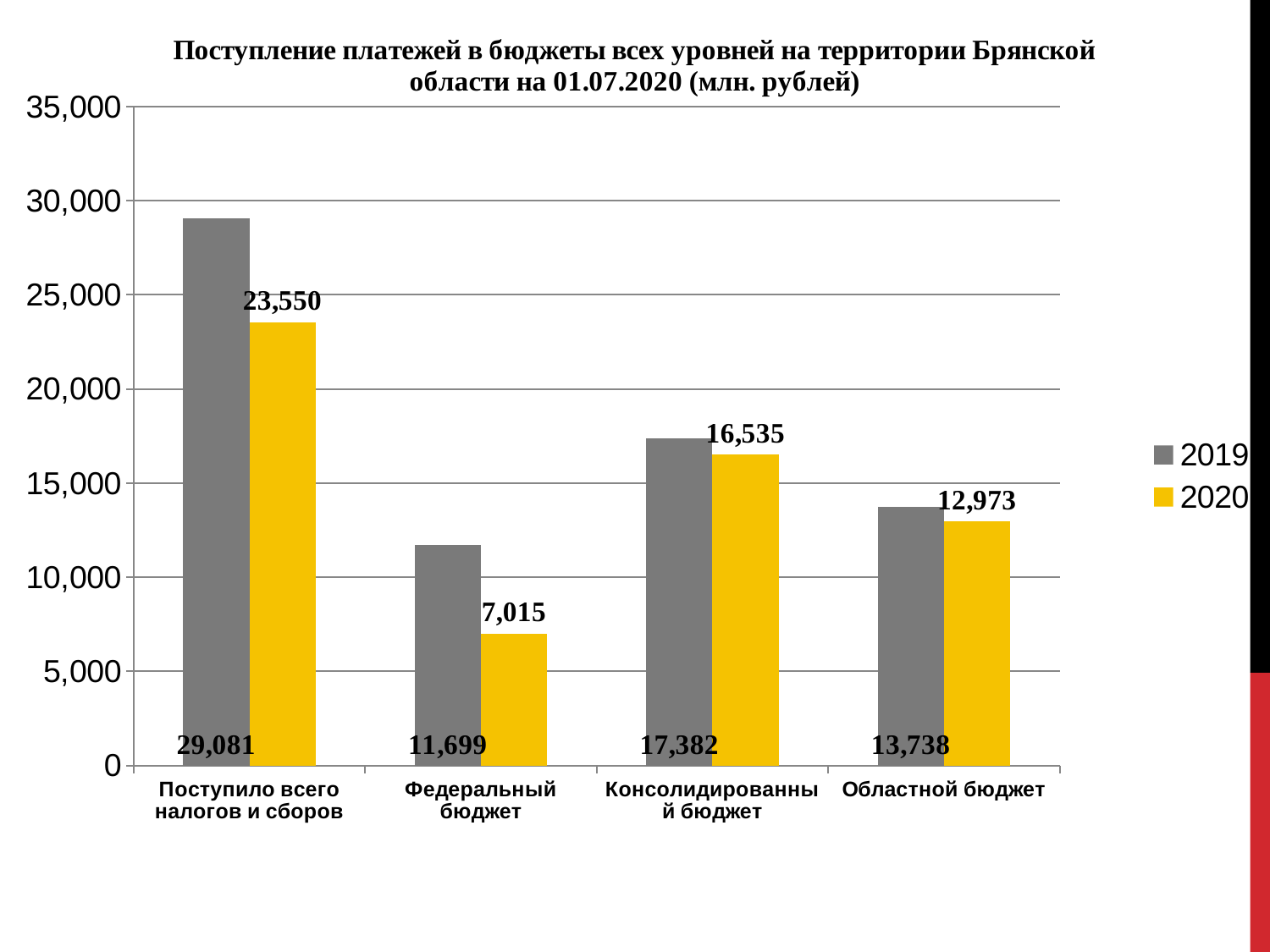
What is the 2019 value for Областной бюджет? 13,738 What kind of chart is shown on the slide? Bar chart Which category has the lowest 2020 value? Федеральный бюджет What is the 2020 value for Поступило всего налогов и сборов? 23,550 Which category has the highest 2019 value? Поступило всего налогов и сборов What is the difference between the 2019 and 2020 values for Поступило всего налогов и сборов? 5,531 Which is larger for Областной бюджет, the 2019 value or the 2020 value? 2019 How many series does the legend list? 2 How many categories are shown on the x axis? 4 What is the 2020 value for Консолидированный бюджет? 16,535 What is the 2019 value for Федеральный бюджет? 11,699 What is the difference between the 2019 and 2020 values for Федеральный бюджет? 4,684